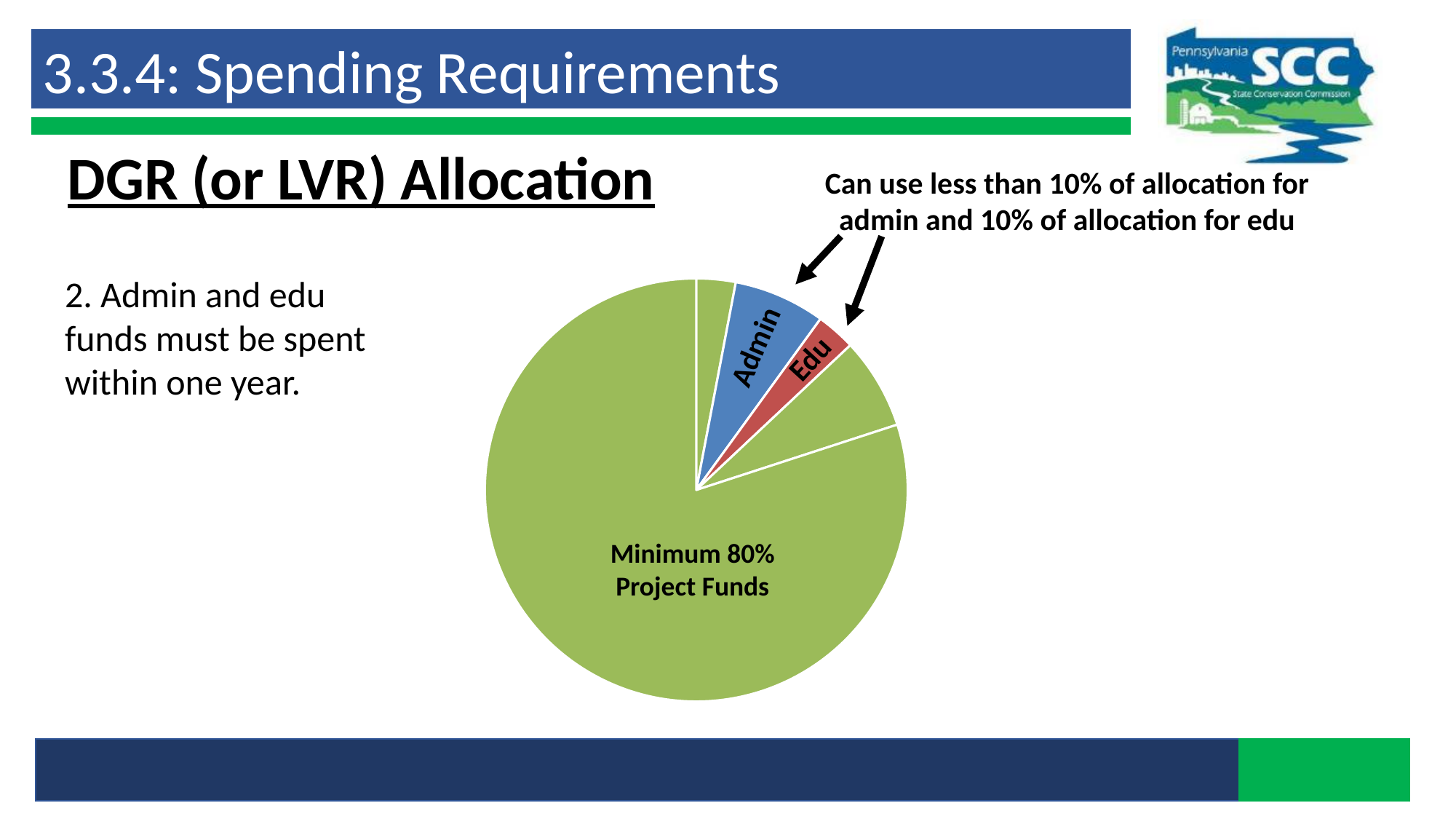
Which slice is larger, Admin or Edu? Admin Which labeled slice of the pie chart is the smallest? Edu What colour is the Edu slice of the pie chart? red What colour is the Admin slice of the pie chart? blue What kind of chart is shown on the slide? pie chart Which labeled slice of the pie chart is the largest? Minimum 80% Project Funds What label is printed on the largest slice of the pie chart? Minimum 80% Project Funds